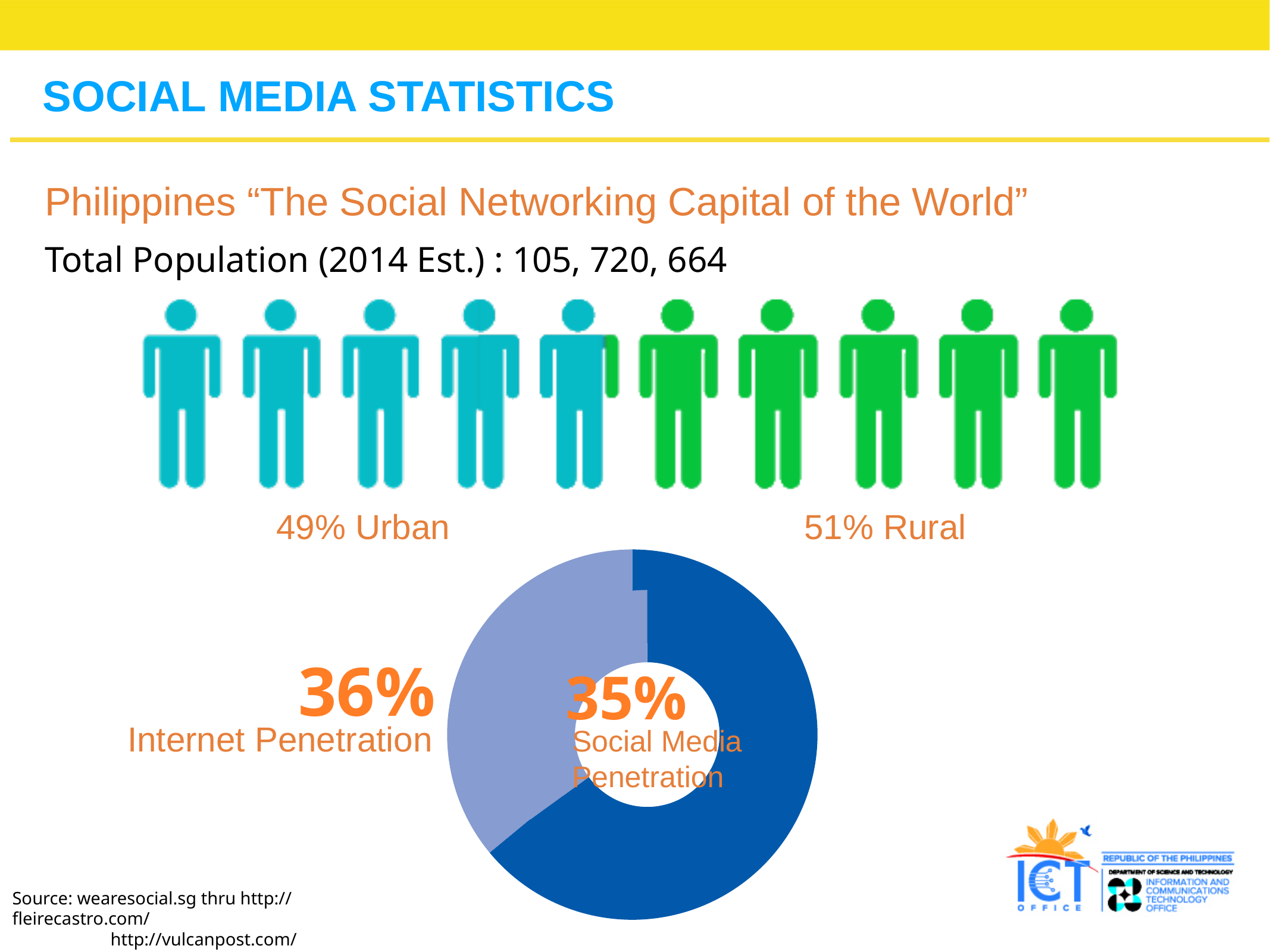
Which is larger, Internet Penetration or Social Media Penetration? Internet Penetration In the pictogram of person icons, what percentage of the population is Rural? 51% What is the Internet Penetration value shown next to the donut chart? 36% In the pictogram, which share is larger, Urban or Rural? Rural What is the Social Media Penetration value shown in the donut chart? 35% How many person icons are shown in the pictogram? 10 What kind of chart is shown at the bottom of the slide? Pie (donut) chart How many of the person icons in the pictogram are green? 5 In the pictogram of person icons, what percentage of the population is Urban? 49% What colour are the Urban person icons in the pictogram? Teal (blue-green) In the pictogram, what is the difference between the Rural and Urban percentages? 2% What is the difference between Internet Penetration and Social Media Penetration? 1%